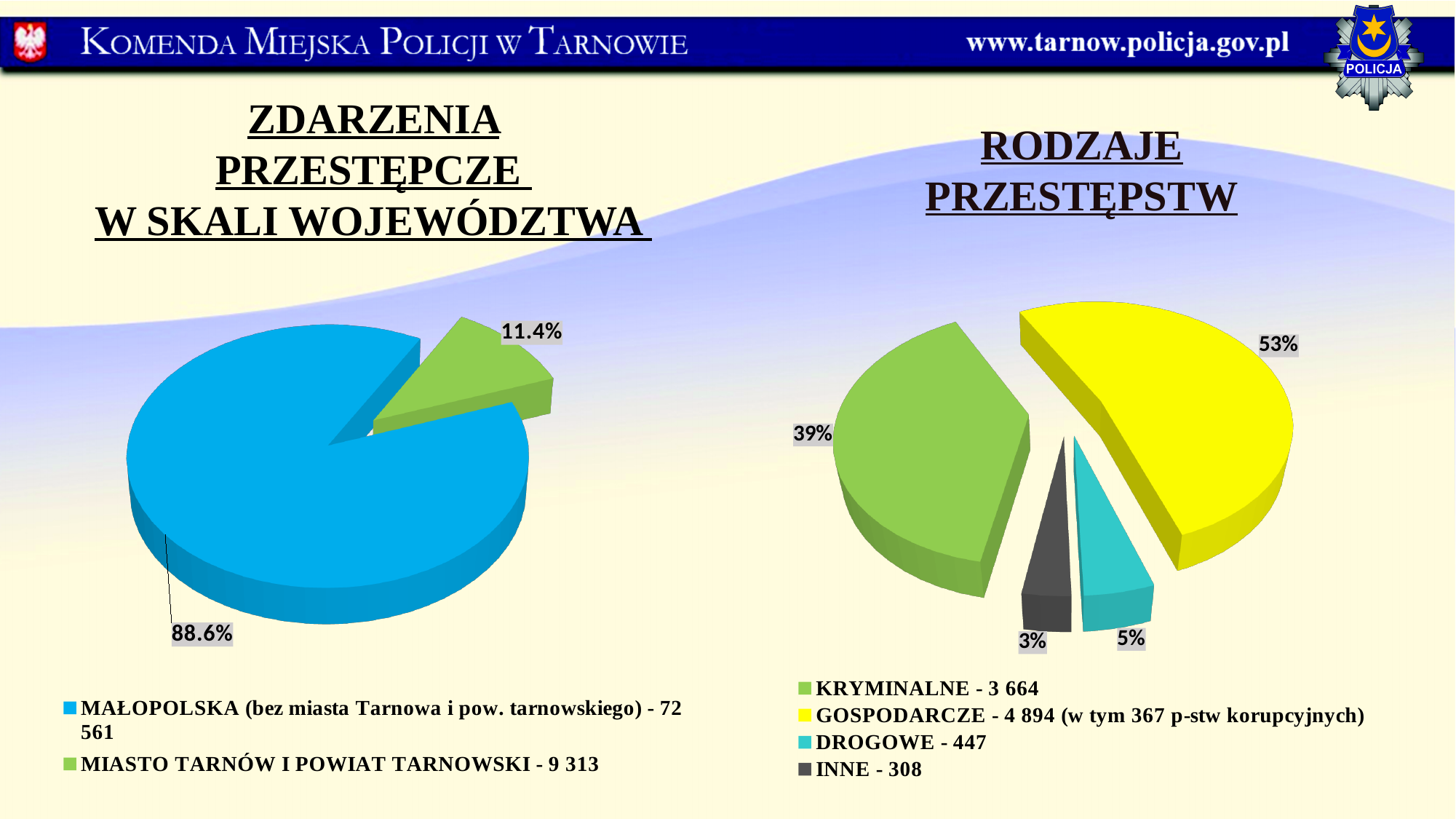
What type of chart is the one titled "RODZAJE PRZESTĘPSTW"? Pie chart In the chart titled "ZDARZENIA PRZESTĘPCZE W SKALI WOJEWÓDZTWA", what percentage share is shown for MAŁOPOLSKA (bez miasta Tarnowa i pow. tarnowskiego)? 88.6% In the chart titled "ZDARZENIA PRZESTĘPCZE W SKALI WOJEWÓDZTWA", how many slices does the pie have? 2 In the chart titled "ZDARZENIA PRZESTĘPCZE W SKALI WOJEWÓDZTWA", what value does the legend give for MIASTO TARNÓW I POWIAT TARNOWSKI? 9 313 In the chart titled "RODZAJE PRZESTĘPSTW", what is the difference between the percentage shares of GOSPODARCZE and KRYMINALNE? 14% In the chart titled "RODZAJE PRZESTĘPSTW", which category has the smallest share? INNE In the chart titled "ZDARZENIA PRZESTĘPCZE W SKALI WOJEWÓDZTWA", what percentage share is shown for MIASTO TARNÓW I POWIAT TARNOWSKI? 11.4% In the chart titled "RODZAJE PRZESTĘPSTW", what value does the legend give for DROGOWE? 447 In the chart titled "RODZAJE PRZESTĘPSTW", which colour represents KRYMINALNE? Green In the chart titled "RODZAJE PRZESTĘPSTW", which category has the largest share? GOSPODARCZE In the chart titled "RODZAJE PRZESTĘPSTW", how many categories does the legend list? 4 In the chart titled "RODZAJE PRZESTĘPSTW", what percentage share is shown for GOSPODARCZE? 53%